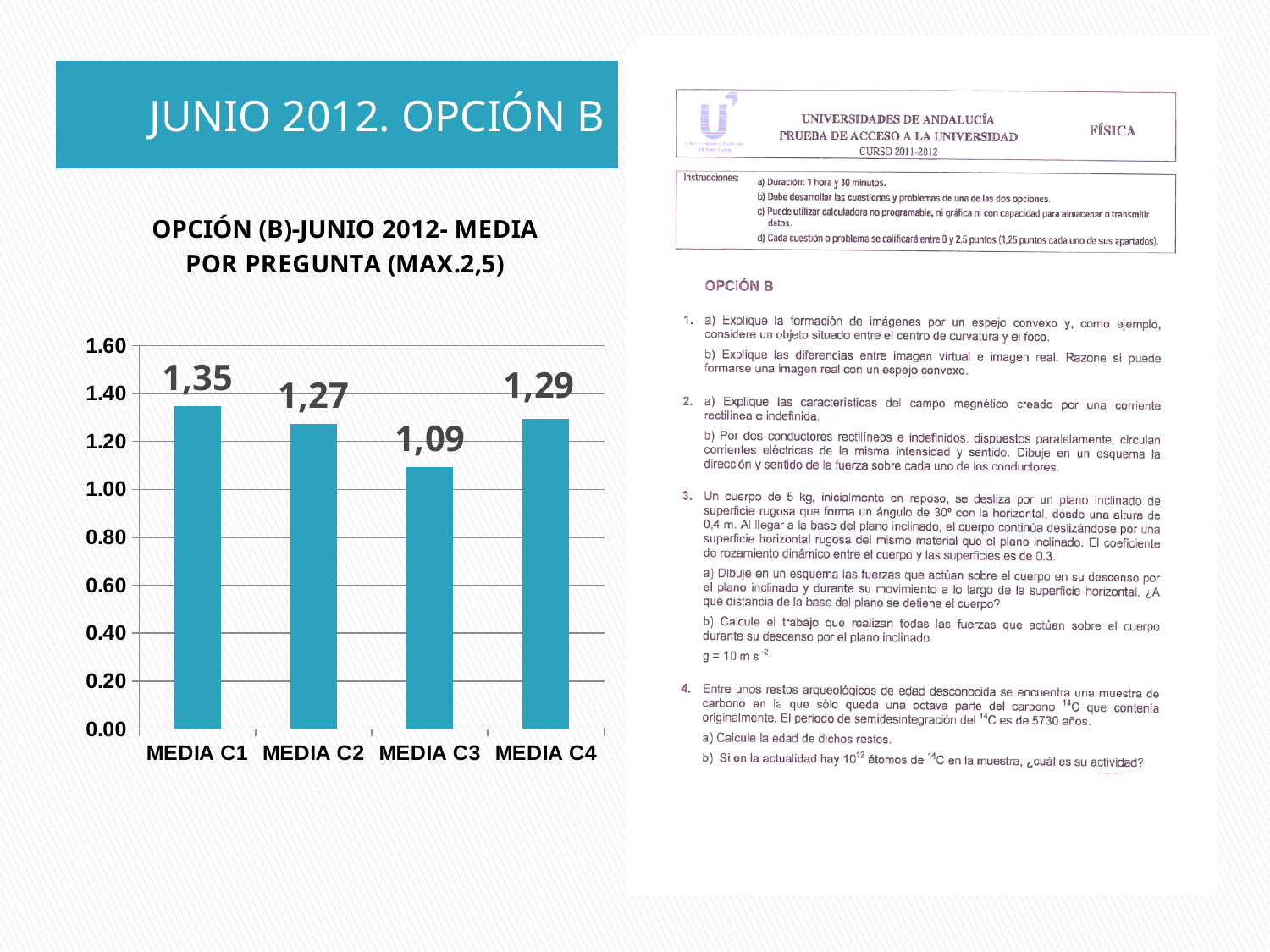
Which category has the highest value? MEDIA C1 What is the value for MEDIA C1? 1,35 How many categories are shown on the chart? 4 What is the difference between the values for MEDIA C1 and MEDIA C3? 0,26 What is the title of the chart? OPCIÓN (B)-JUNIO 2012- MEDIA POR PREGUNTA (MAX.2,5) Which is larger, the value for MEDIA C2 or MEDIA C4? MEDIA C4 What is the value for MEDIA C4? 1,29 Which category has the lowest value? MEDIA C3 What is the value for MEDIA C3? 1,09 What kind of chart is shown on the slide? bar chart What is the highest value shown on the y axis? 1.60 Is the value for MEDIA C2 greater or less than 1.20? greater